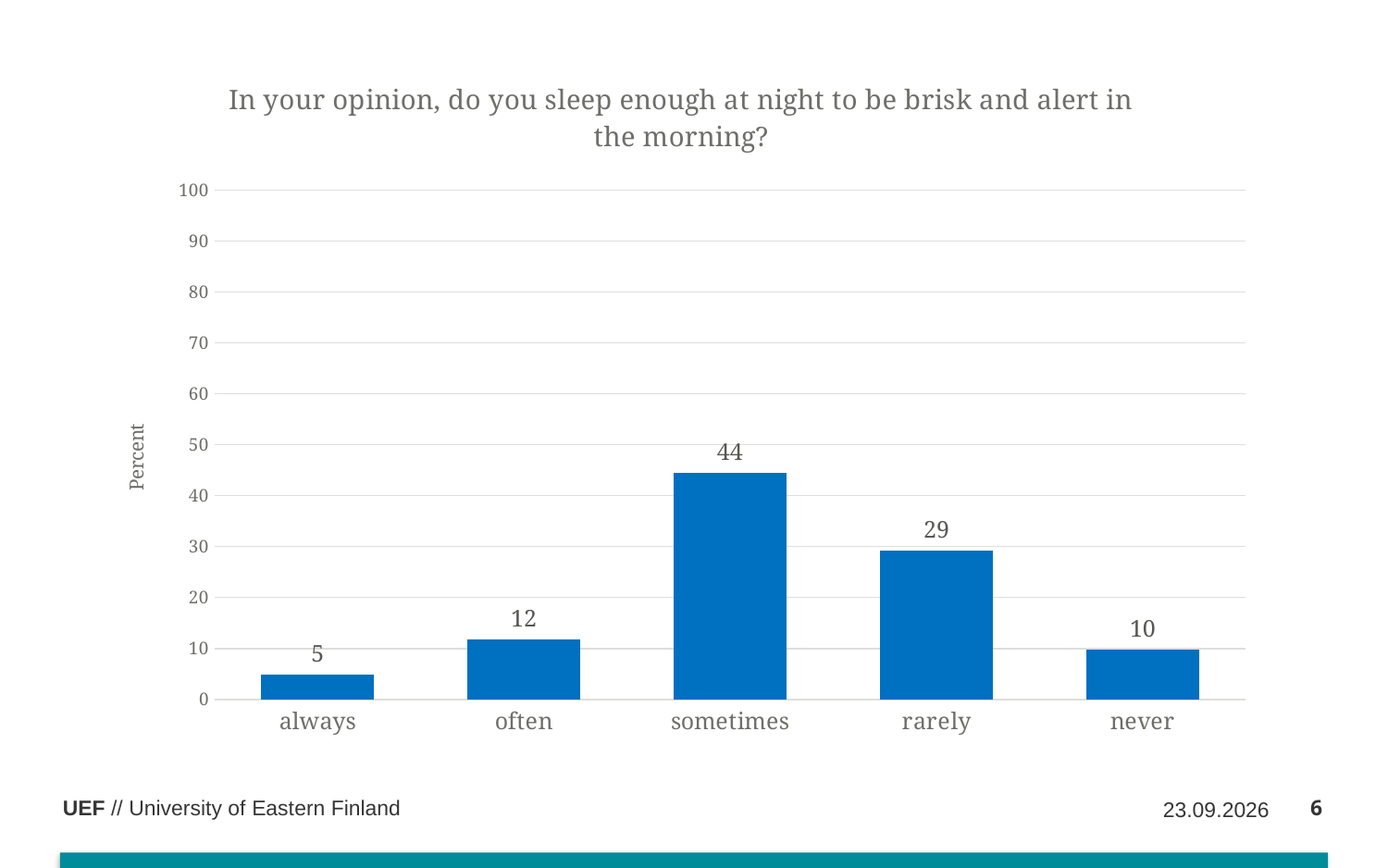
How many categories are shown on the x axis? 5 What is the difference between the values for "often" and "never"? 2 What is the value for "always"? 5 Which category has the lowest value? always Which category has the highest value? sometimes Which is larger, the value for "rarely" or the value for "never"? rarely Is the value for "sometimes" greater or less than 40? greater What is the difference between the values for "sometimes" and "rarely"? 15 What is the label of the y axis? Percent What is the value for "sometimes"? 44 What kind of chart is shown on the slide? bar chart What is the value for "rarely"? 29